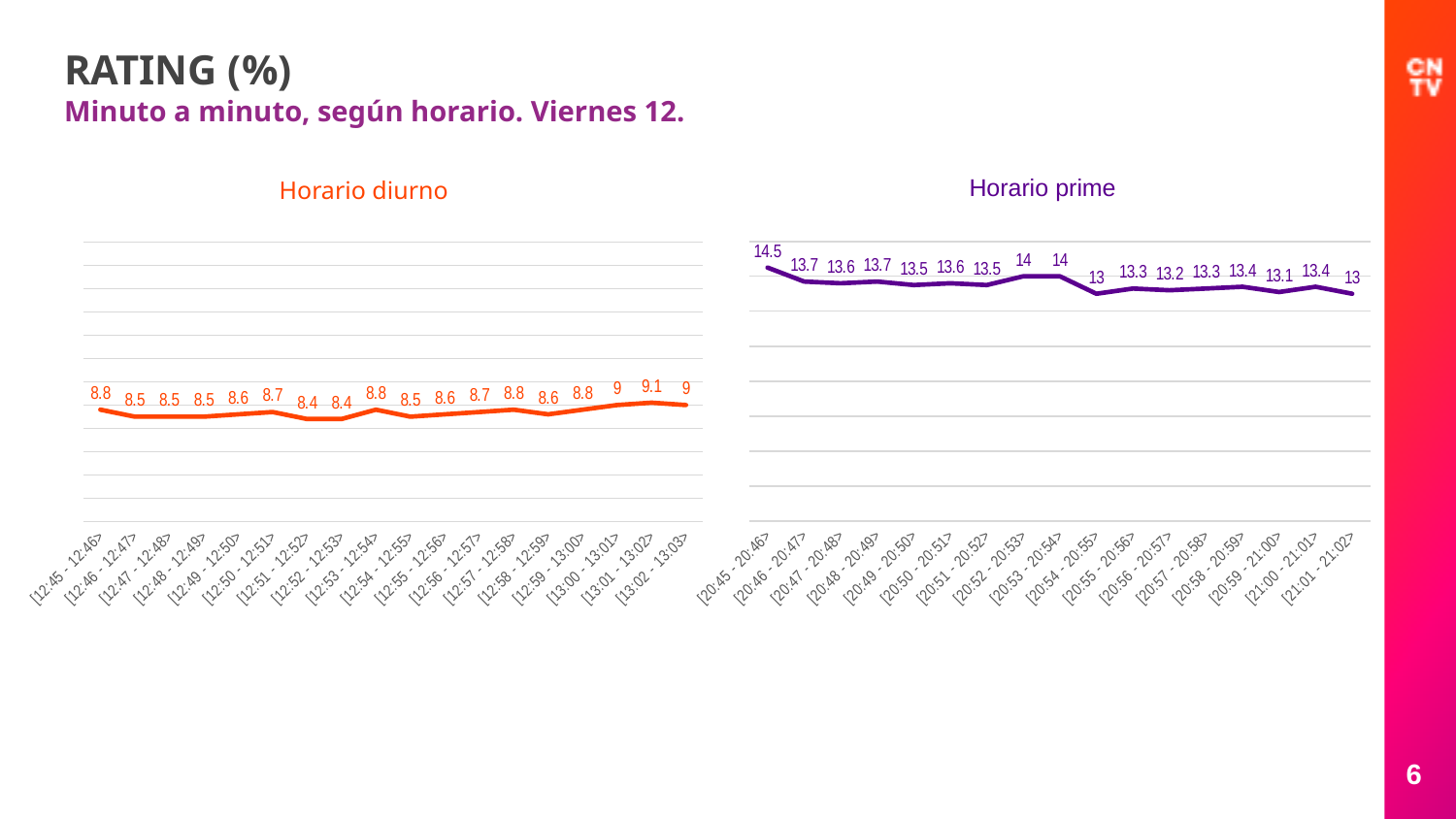
In the Horario prime chart, what is the rating for [20:45 - 20:46>? 14.5 What colour is the line in the Horario prime chart? Purple In the Horario diurno chart, what is the rating for [12:45 - 12:46>? 8.8 In the Horario diurno chart, which time interval has the highest rating? [13:01 - 13:02> In the Horario prime chart, which time interval has the highest rating? [20:45 - 20:46> In the Horario prime chart, what is the rating for [20:52 - 20:53>? 14 In the Horario diurno chart, which is larger: the rating at [12:52 - 12:53> or at [13:01 - 13:02>? [13:01 - 13:02> How many data points are plotted in the Horario prime chart? 17 How many data points are plotted in the Horario diurno chart? 18 In the Horario prime chart, what is the lowest rating value shown? 13 What type of chart is used for Horario diurno? Line chart In the Horario prime chart, what is the difference between the rating at [20:45 - 20:46> and the rating at [21:01 - 21:02>? 1.5